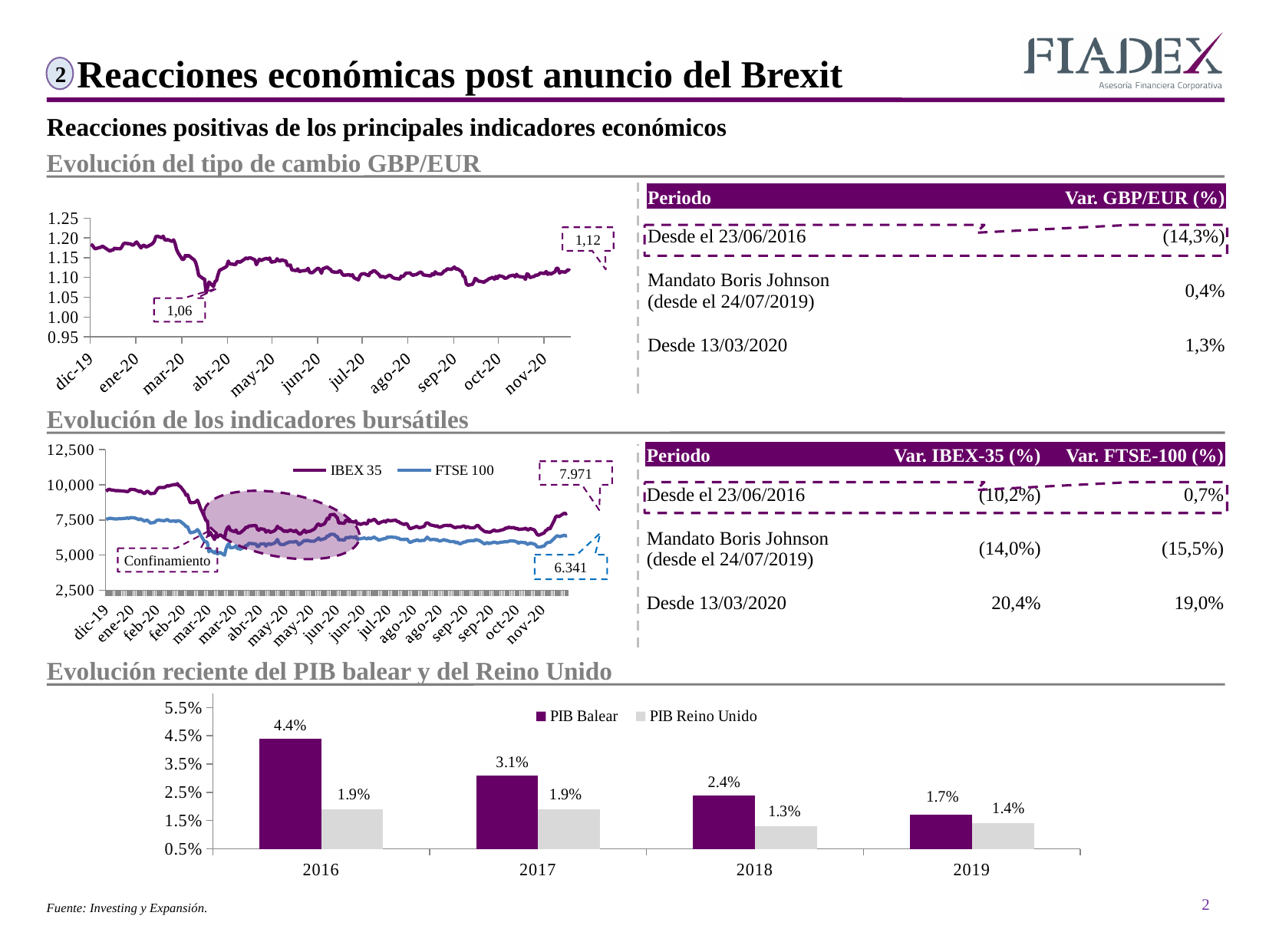
In the bar chart 'Evolución reciente del PIB balear y del Reino Unido', what is the difference between PIB Balear and PIB Reino Unido in 2017? 1.2 percentage points In the bar chart 'Evolución reciente del PIB balear y del Reino Unido', which is larger in 2019, PIB Balear or PIB Reino Unido? PIB Balear How many years are shown on the x axis of the bar chart 'Evolución reciente del PIB balear y del Reino Unido'? 4 In the bar chart 'Evolución reciente del PIB balear y del Reino Unido', which year has the lowest PIB Reino Unido value? 2018 In the bar chart 'Evolución reciente del PIB balear y del Reino Unido', which year has the highest PIB Balear value? 2016 How many series does the legend of the bar chart 'Evolución reciente del PIB balear y del Reino Unido' list? 2 In the chart 'Evolución del tipo de cambio GBP/EUR', what value is labelled at the end of the line (nov-20)? 1,12 What kind of chart is 'Evolución reciente del PIB balear y del Reino Unido'? Bar chart In the bar chart 'Evolución reciente del PIB balear y del Reino Unido', what is the value of PIB Balear for 2016? 4.4% In the bar chart 'Evolución reciente del PIB balear y del Reino Unido', what is the value of PIB Reino Unido for 2018? 1.3% In the bar chart 'Evolución reciente del PIB balear y del Reino Unido', does PIB Balear rise or fall from 2016 to 2019? Fall In the chart 'Evolución de los indicadores bursátiles', what value is labelled at the end of the IBEX 35 line? 7.971